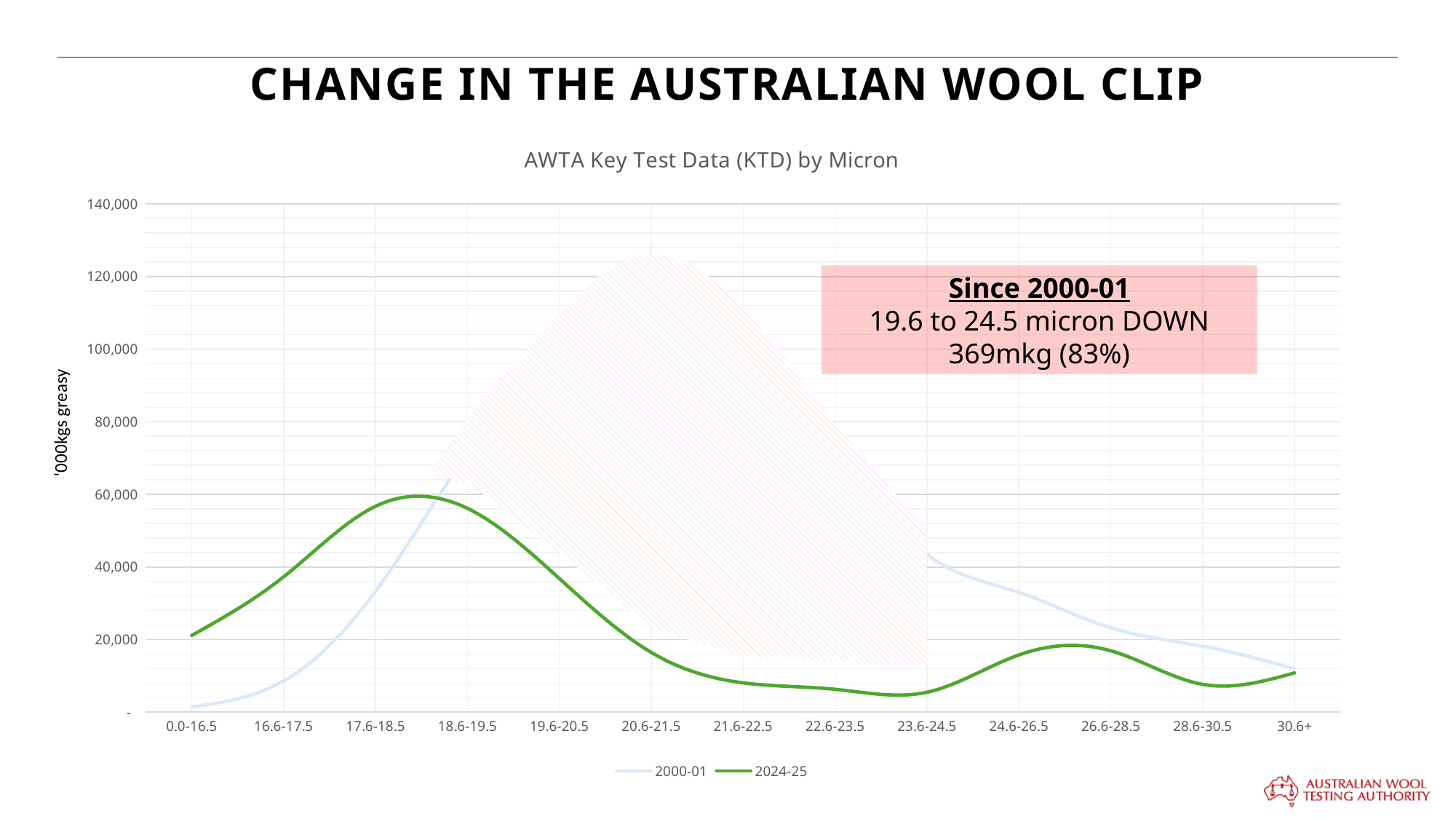
At 17.6-18.5, which series has the larger value, 2000-01 or 2024-25? 2024-25 Which micron category has the highest value for the 2000-01 series? 20.6-21.5 Is the 2000-01 value for 30.6+ greater or less than 20,000? less Does the 2000-01 series rise or fall from 23.6-24.5 to 30.6+? Fall Which micron category has the lowest value for the 2000-01 series? 0.0-16.5 What is the title of the chart? AWTA Key Test Data (KTD) by Micron Is the 2024-25 value for 19.6-20.5 greater or less than 40,000? less Is the 2000-01 value for 18.6-19.5 greater or less than 60,000? greater How many micron categories are shown on the x axis? 13 What is the label on the vertical axis? '000kgs greasy What kind of chart is shown on the slide? Line chart How many series does the chart legend list? 2